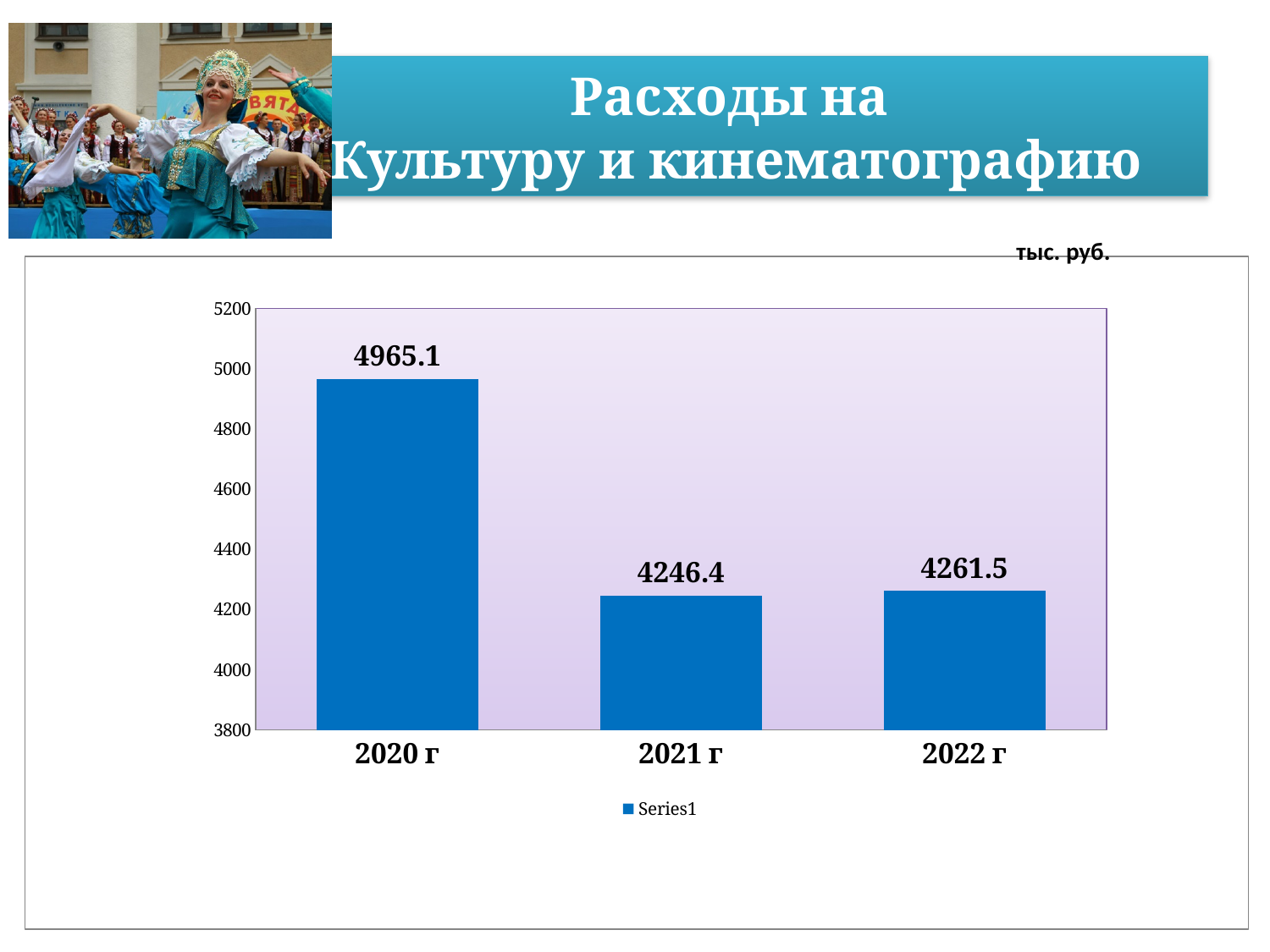
Which is larger, the value for 2020 г or the value for 2022 г? 2020 г Which year has the lowest value? 2021 г What is the difference between the values for 2022 г and 2021 г? 15.1 How many years are shown on the x axis? 3 What is the value for 2020 г? 4965.1 What kind of chart is shown on the slide? bar chart What is the value for 2022 г? 4261.5 Is the value for 2021 г greater or less than 4400? less What unit is indicated above the chart? тыс. руб. Which year has the highest value? 2020 г What is the value for 2021 г? 4246.4 What is the difference between the values for 2020 г and 2021 г? 718.7